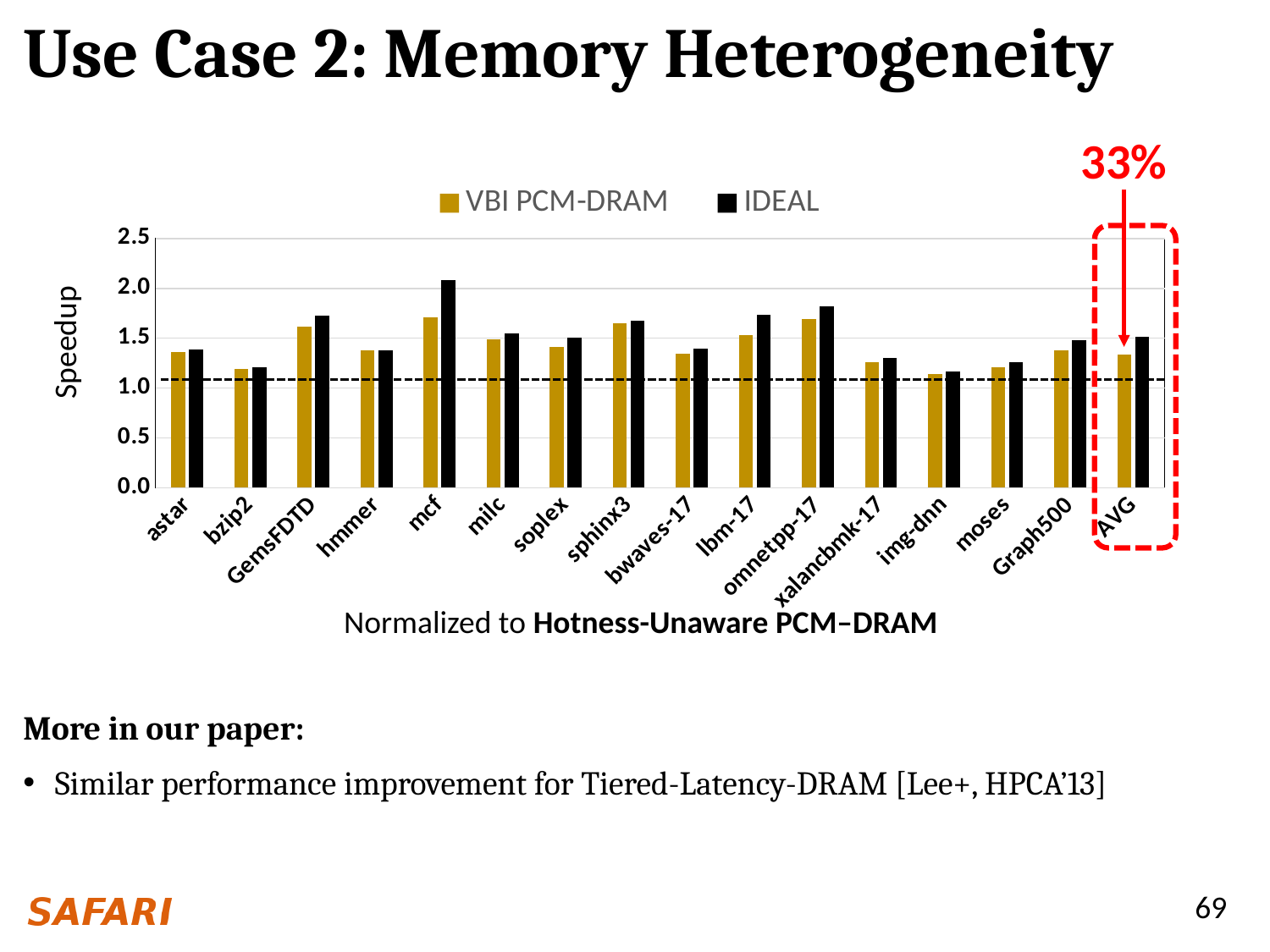
How many series does the legend list? 2 How many categories are shown along the x axis? 16 Is the IDEAL speedup for mcf greater or less than 2.0? greater What kind of chart is shown on the slide? bar chart Is the IDEAL speedup for omnetpp-17 greater or less than 1.5? greater For mcf, which series has the larger speedup, VBI PCM-DRAM or IDEAL? IDEAL Which has the larger IDEAL speedup, mcf or GemsFDTD? mcf What percentage is annotated in red above the AVG bars? 33% Is the VBI PCM-DRAM speedup for img-dnn greater or less than 1.5? less What is the label on the y axis of the chart? Speedup Which category has the highest IDEAL speedup? mcf